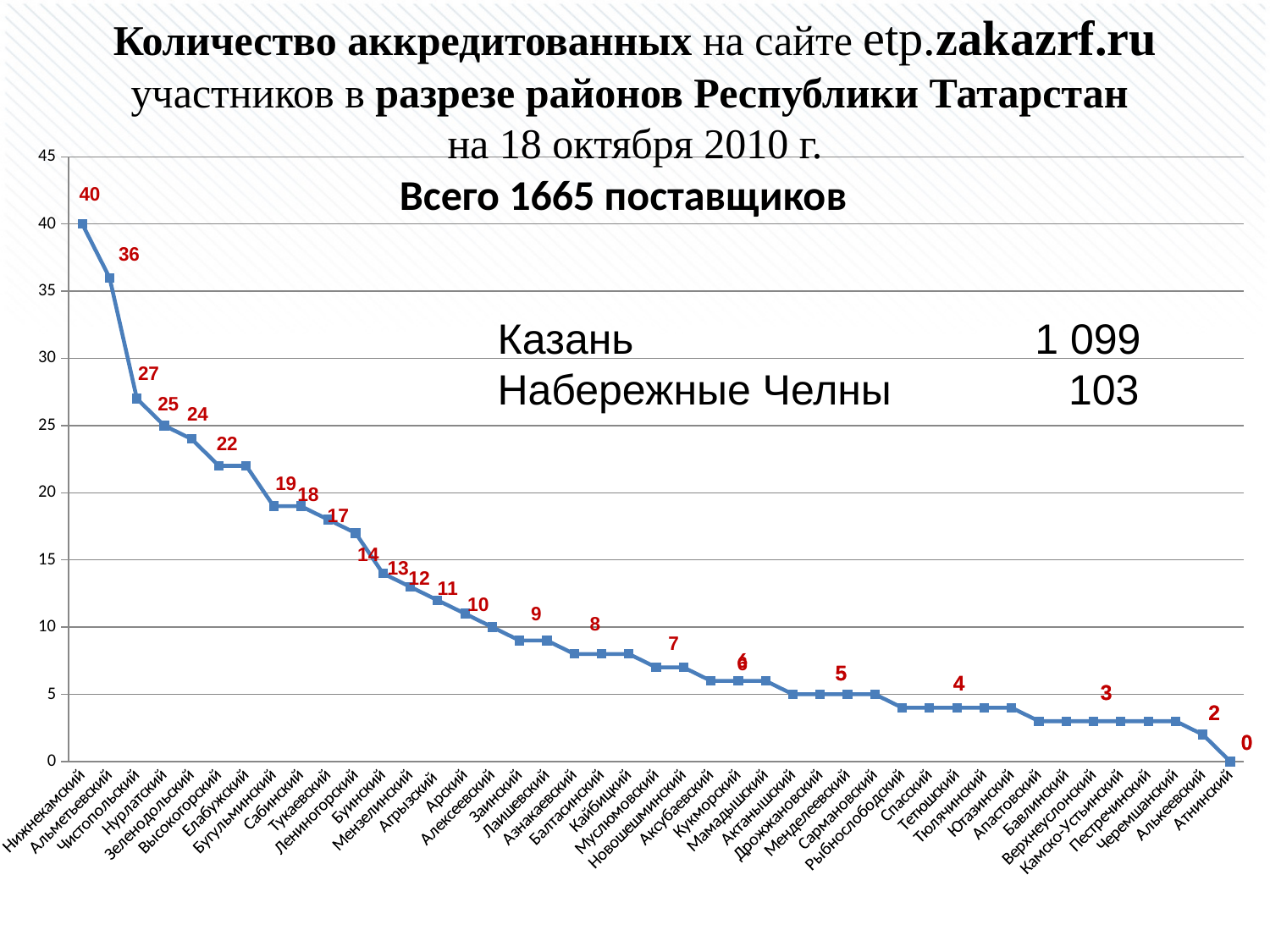
Is the value for Зеленодольский greater or less than 20? greater According to the chart heading, what is the total number of suppliers? 1665 Which district has the lowest number of accredited participants? Атнинский What is the difference between the values for Нижнекамский and Альметьевский? 4 Which district has the highest number of accredited participants? Нижнекамский What is the value shown for Чистопольский? 27 How many accredited participants does Альметьевский have? 36 What kind of chart is shown on the slide? line chart How many accredited participants does Нижнекамский have? 40 Which has a larger value, Чистопольский or Нурлатский? Чистопольский What is the value shown for Атнинский? 0 Do the values rise or fall from left to right along the x axis? fall